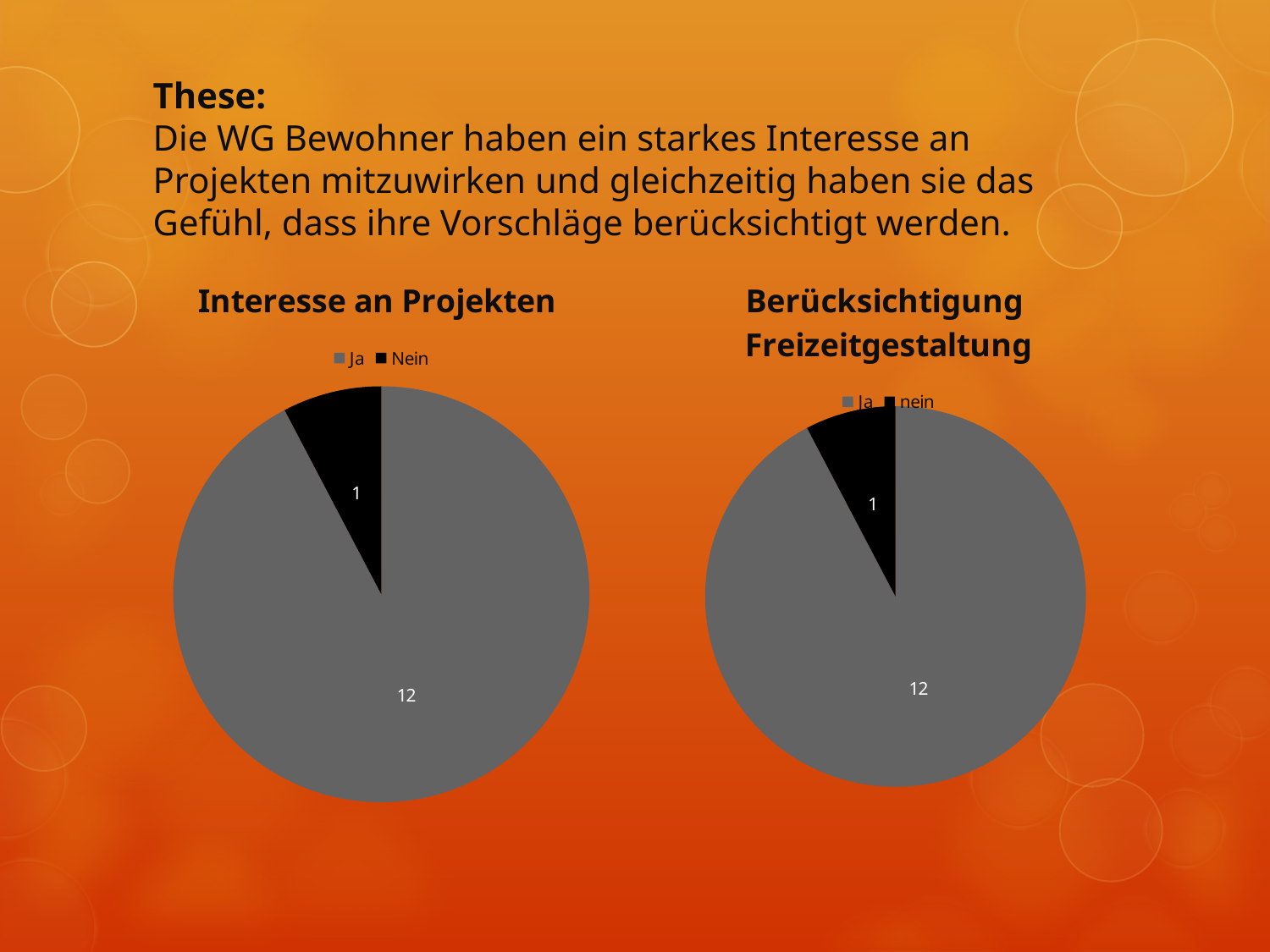
In the 'Interesse an Projekten' chart, what is the value for Nein? 1 In the 'Berücksichtigung Freizeitgestaltung' chart, what is the value for Ja? 12 In the 'Interesse an Projekten' chart, what is the difference between the Ja and Nein values? 11 In the 'Interesse an Projekten' chart, what is the total of all slices? 13 How many slices does the 'Berücksichtigung Freizeitgestaltung' chart have? 2 In the 'Interesse an Projekten' chart, what is the value for Ja? 12 In the 'Berücksichtigung Freizeitgestaltung' chart, which category has the smallest slice? nein In the 'Interesse an Projekten' chart, what colour is the Nein slice? black In the 'Interesse an Projekten' chart, which category has the largest slice? Ja In the 'Berücksichtigung Freizeitgestaltung' chart, is the value for Ja larger or smaller than the value for nein? larger What type of chart is the 'Interesse an Projekten' chart? pie chart In the 'Berücksichtigung Freizeitgestaltung' chart, what is the value for nein? 1